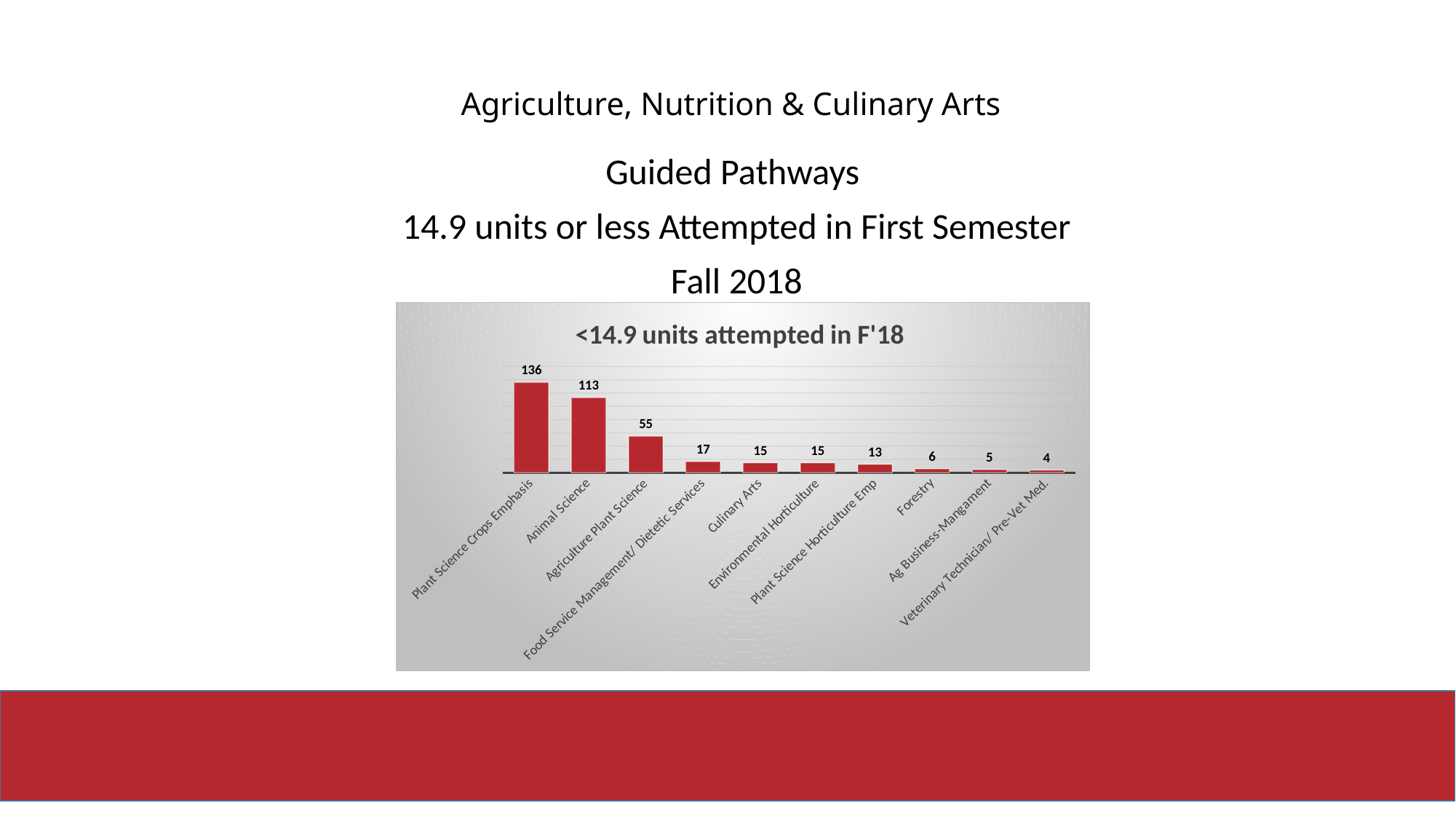
Which is larger, the value for Food Service Management/ Dietetic Services or the value for Plant Science Horticulture Emp? Food Service Management/ Dietetic Services Do the values rise or fall from left to right along the x axis? Fall What is the value for Animal Science? 113 How many categories are shown in the chart? 10 What is the value for Forestry? 6 Which category has the lowest value? Veterinary Technician/ Pre-Vet Med. What is the title of the chart? <14.9 units attempted in F'18 Which category has the highest value? Plant Science Crops Emphasis What is the value for Plant Science Crops Emphasis? 136 What kind of chart is shown on the slide? Bar chart What is the value for Agriculture Plant Science? 55 What is the difference between the values for Plant Science Crops Emphasis and Animal Science? 23